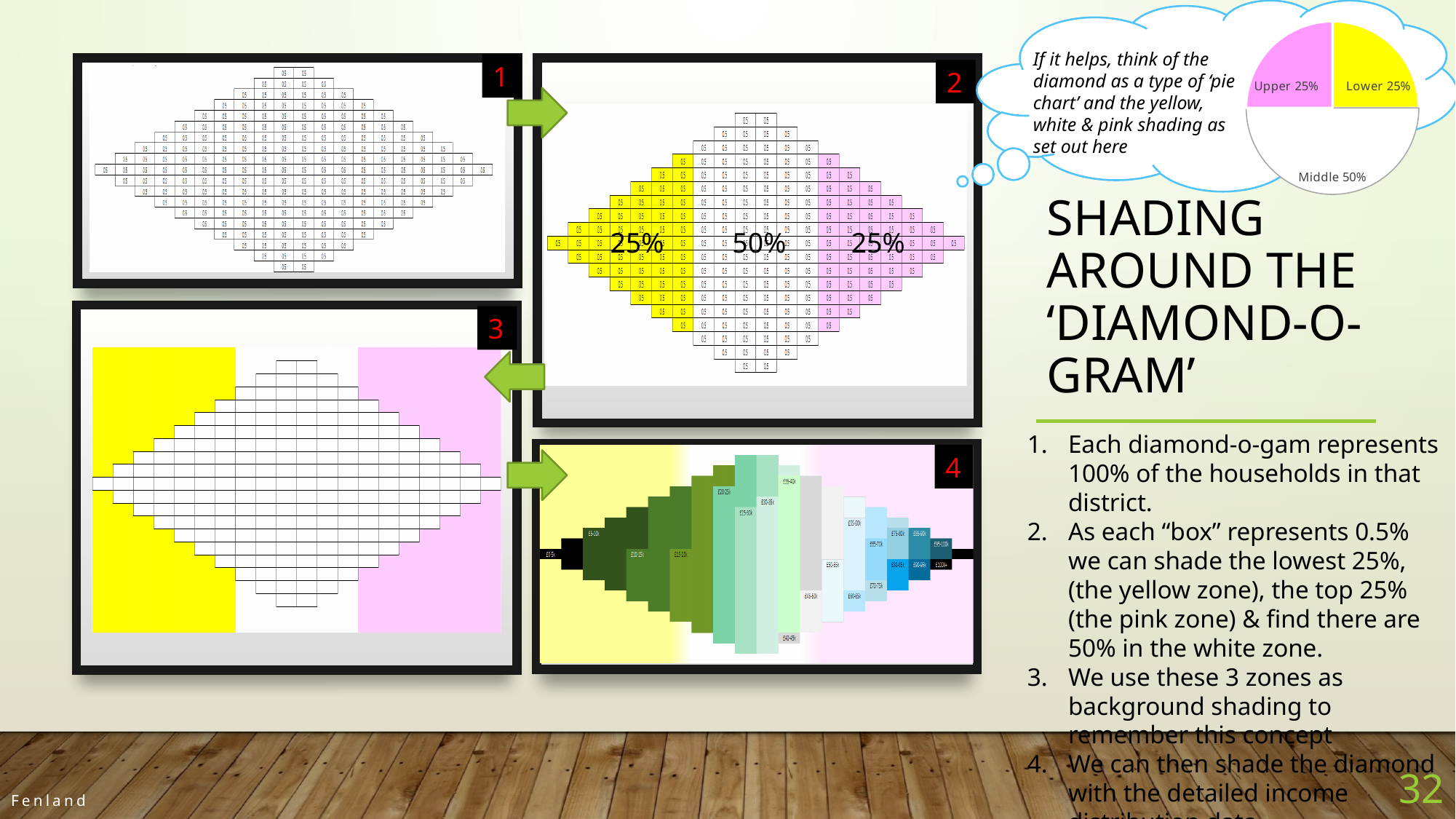
In the pie chart in the thought bubble, what share is labelled for the 'Lower' slice? 25% Which slice of the pie chart in the thought bubble is the largest? Middle 50% In the pie chart in the thought bubble, what share is labelled for the 'Middle' slice? 50% In the diamond-o-gram labelled 2, what percentage is printed over the yellow zone? 25% How many slices does the pie chart in the thought bubble have? 3 In the pie chart in the thought bubble, what colour is the 'Upper 25%' slice? pink In the pie chart in the thought bubble, what share is labelled for the 'Upper' slice? 25% In the pie chart in the thought bubble, what colour is the 'Lower 25%' slice? yellow In the pie chart in the thought bubble, is the Middle slice larger or smaller than the Upper slice? larger In the diamond-o-gram labelled 2, what percentage is printed over the white middle zone? 50% In the pie chart in the thought bubble, what is the difference between the Middle share and the Lower share? 25% What kind of chart is shown inside the thought bubble at the top right of the slide? pie chart